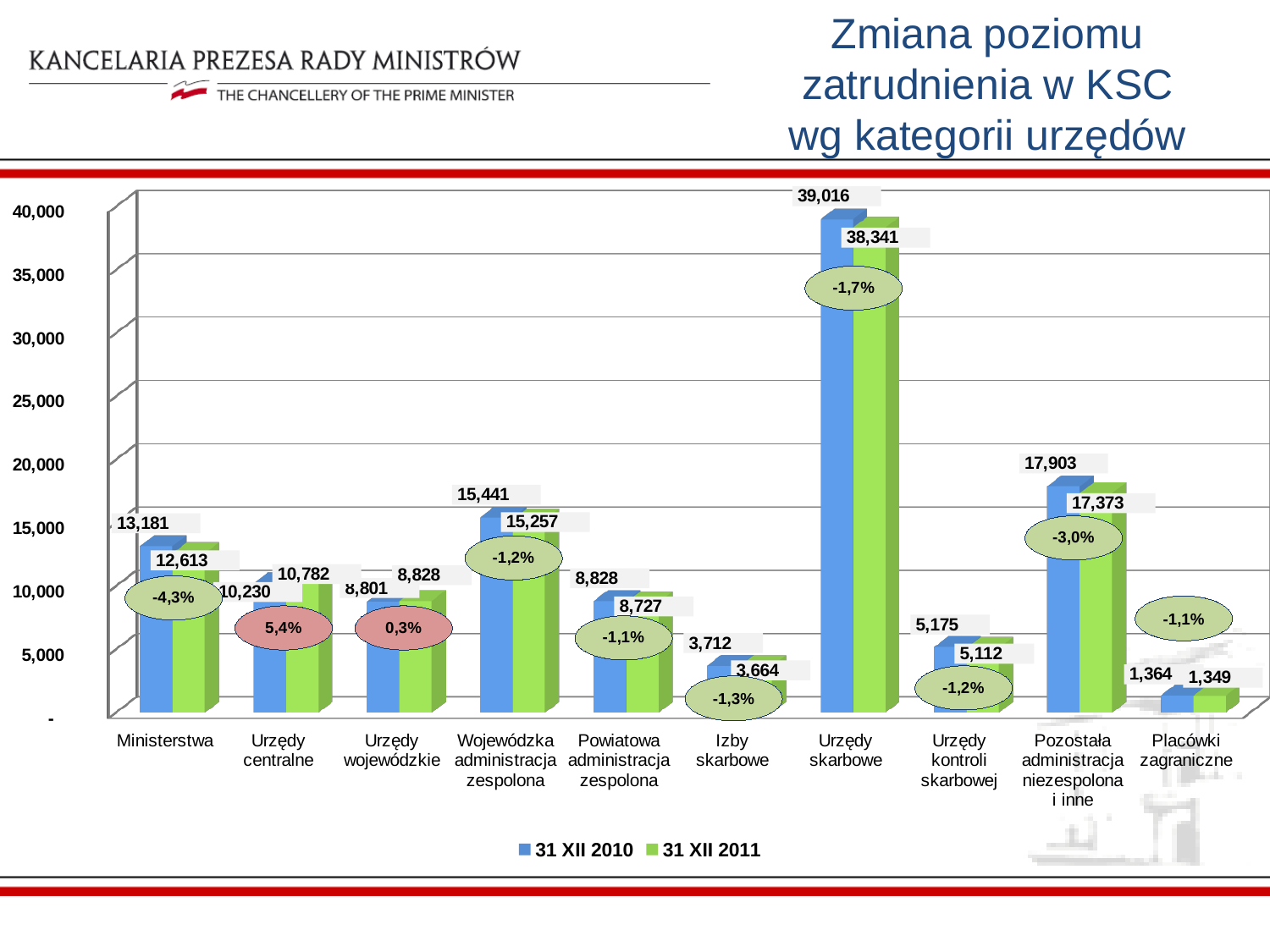
Which category has the highest employment level on 31 XII 2011? Urzędy skarbowe What was the employment level in Ministerstwa on 31 XII 2011? 12,613 Which is larger for Urzędy wojewódzkie: the 31 XII 2010 value or the 31 XII 2011 value? 31 XII 2011 How many categories of offices are shown on the x axis? 10 Is the 31 XII 2011 value for Wojewódzka administracja zespolona greater or less than 15,000? greater What percentage change is shown for Urzędy centralne? 5,4% Which category has the lowest employment level on 31 XII 2010? Placówki zagraniczne What is the title of the chart? Zmiana poziomu zatrudnienia w KSC wg kategorii urzędów How many series does the legend list? 2 What kind of chart is shown on the slide? bar chart What was the employment level in Urzędy skarbowe on 31 XII 2010? 39,016 What is the difference between the 31 XII 2010 and 31 XII 2011 values for Pozostała administracja niezespolona i inne? 530